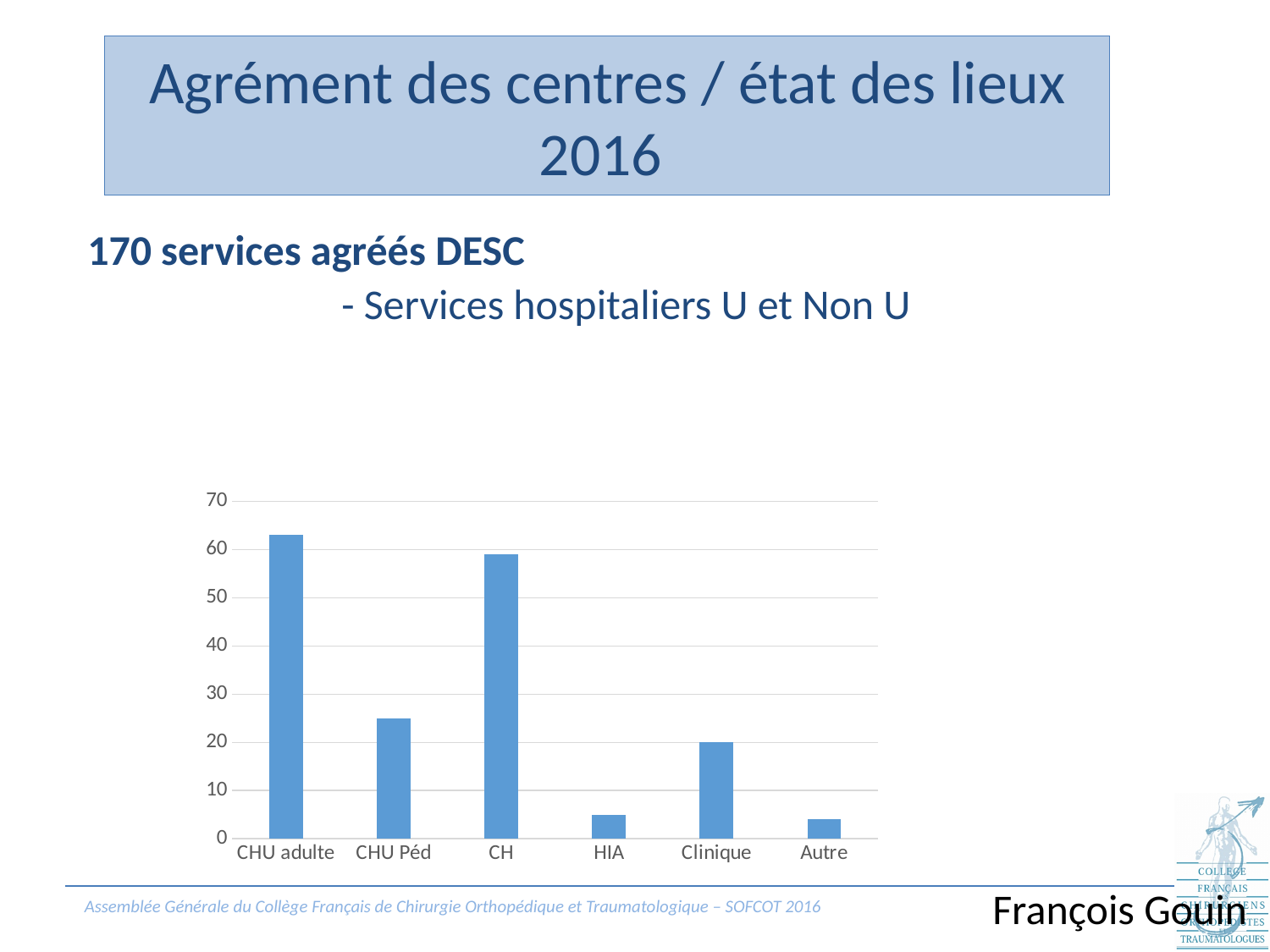
Which is larger, the value for CHU Péd or the value for Clinique? CHU Péd Is the value for CHU Péd greater or less than 20? greater What colour are the bars in the chart? blue What kind of chart is shown on the slide? bar chart Which category has the highest bar in the chart? CHU adulte Which is larger, the value for CH or the value for HIA? CH Is the value for Autre greater or less than 10? less How many categories are shown on the x axis of the chart? 6 Is the value for HIA greater or less than 10? less